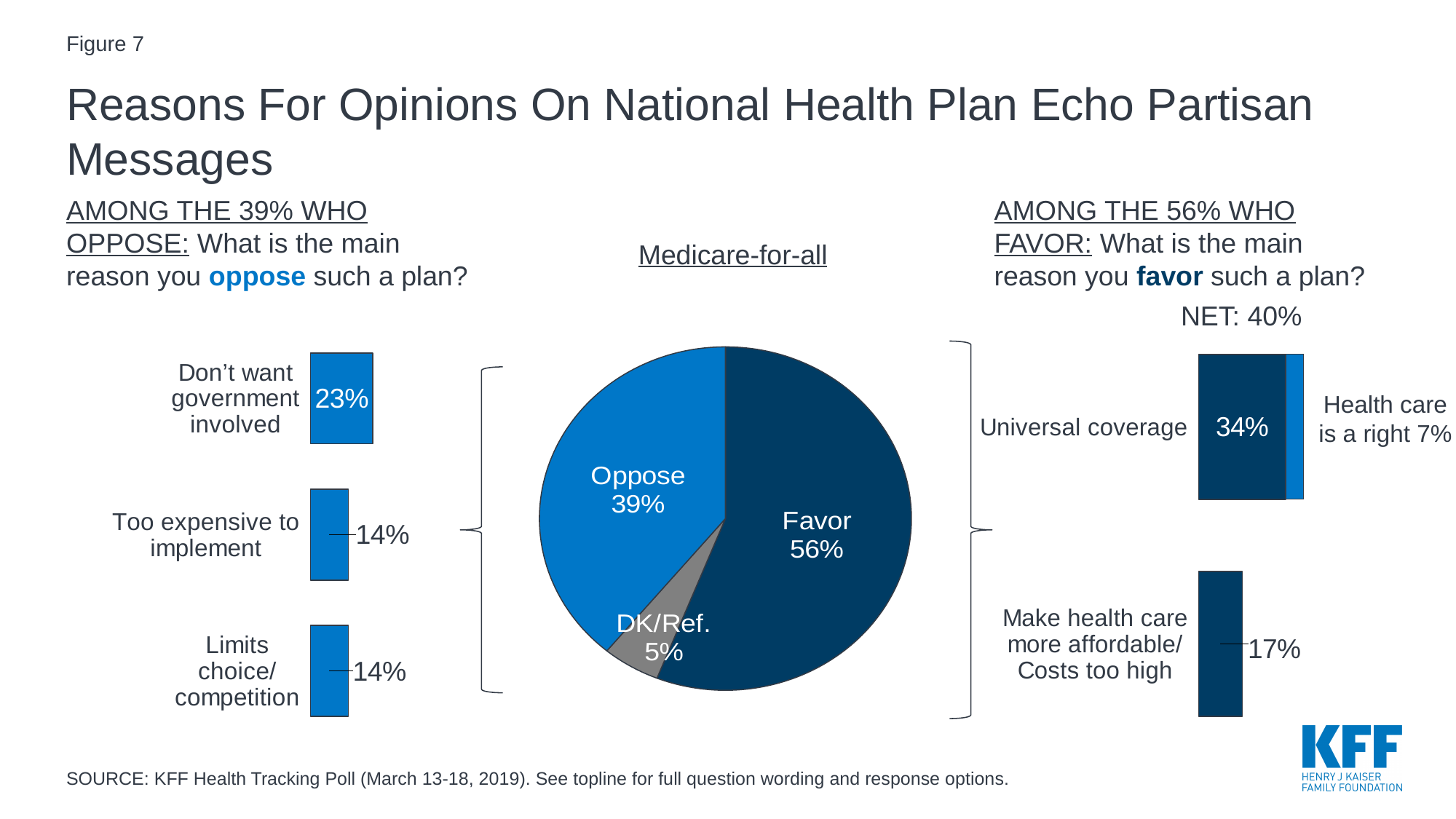
In the bar chart on the left (among those who oppose), what is the value for 'Don't want government involved'? 23% In the Medicare-for-all pie chart in the center, what share of respondents favor the plan? 56% In the Medicare-for-all pie chart in the center, what is the difference between the Favor and Oppose shares? 17% In the bar chart on the right (among those who favor), what is the value for 'Make health care more affordable/Costs too high'? 17% In the Medicare-for-all pie chart in the center, what share is DK/Ref.? 5% In the bar chart on the right (among those who favor), what is the value for 'Universal coverage'? 34% In the Medicare-for-all pie chart in the center, what share of respondents oppose the plan? 39% In the Medicare-for-all pie chart in the center, which slice is the largest? Favor In the Medicare-for-all pie chart in the center, which slice is the smallest? DK/Ref. In the bar chart on the left (among those who oppose), what is the value for 'Too expensive to implement'? 14% In the Medicare-for-all pie chart in the center, how many slices are there? 3 In the bar chart on the left (among those who oppose), which reason has the highest value? Don't want government involved